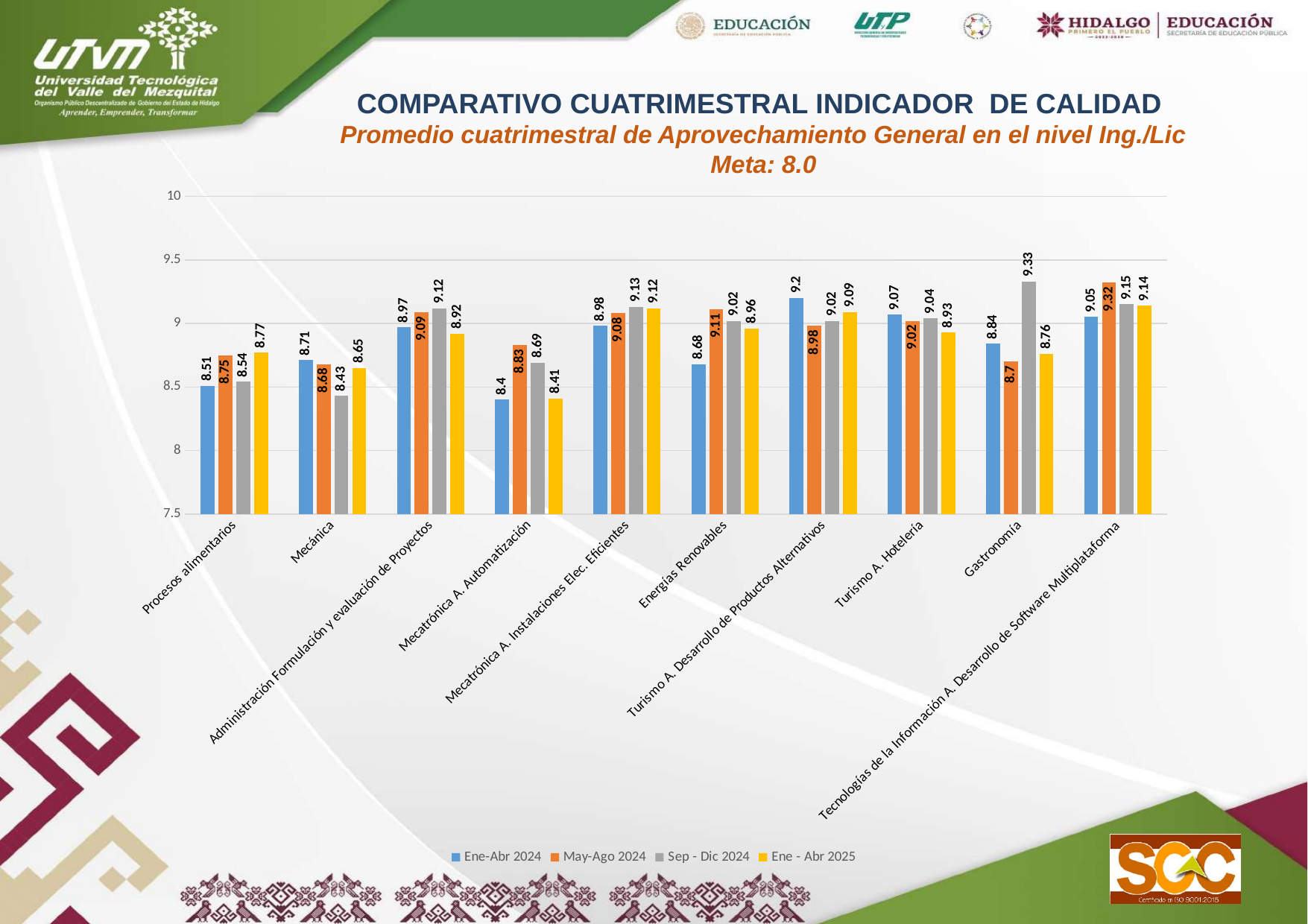
How many categories are shown on the x axis? 10 What is the value for Mecánica in the Ene-Abr 2024 series? 8.71 Which category has the highest value in the Sep - Dic 2024 series? Gastronomía How many series does the legend list? 4 What is the value for Gastronomía in the Sep - Dic 2024 series? 9.33 What is the value for Turismo A. Hotelería in the Ene - Abr 2025 series? 8.93 What is the difference between the Sep - Dic 2024 and May-Ago 2024 values for Gastronomía? 0.63 Which is larger for Procesos alimentarios: the Ene-Abr 2024 value or the Ene - Abr 2025 value? Ene - Abr 2025 What is the value for Energías Renovables in the May-Ago 2024 series? 9.11 What is the target (Meta) stated in the chart title? 8.0 What kind of chart is shown on the slide? Bar chart Which category has the lowest value in the Ene-Abr 2024 series? Mecatrónica A. Automatización